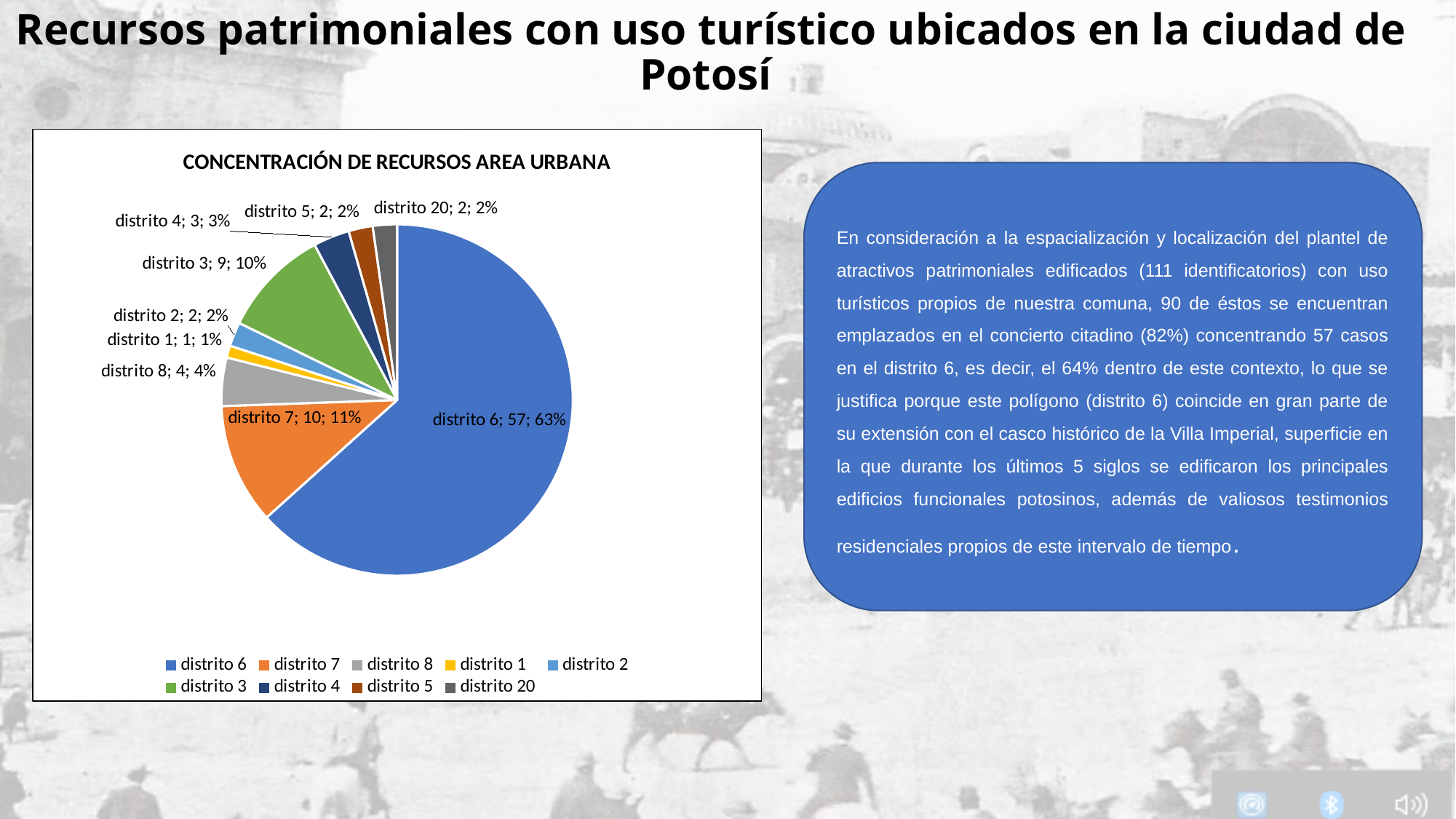
Which district has the largest slice? distrito 6 What share of the pie does distrito 3 represent? 10% What is the value for distrito 6? 57 What is the value for distrito 7? 10 Which is larger, the value for distrito 3 or the value for distrito 8? distrito 3 What is the difference between the values for distrito 6 and distrito 7? 47 What is the value for distrito 4? 3 Which district has the smallest slice? distrito 1 What is the title of the chart? CONCENTRACIÓN DE RECURSOS AREA URBANA What kind of chart is shown on the slide? pie chart What share of the pie does distrito 6 represent? 63% How many slices does the pie chart have? 9